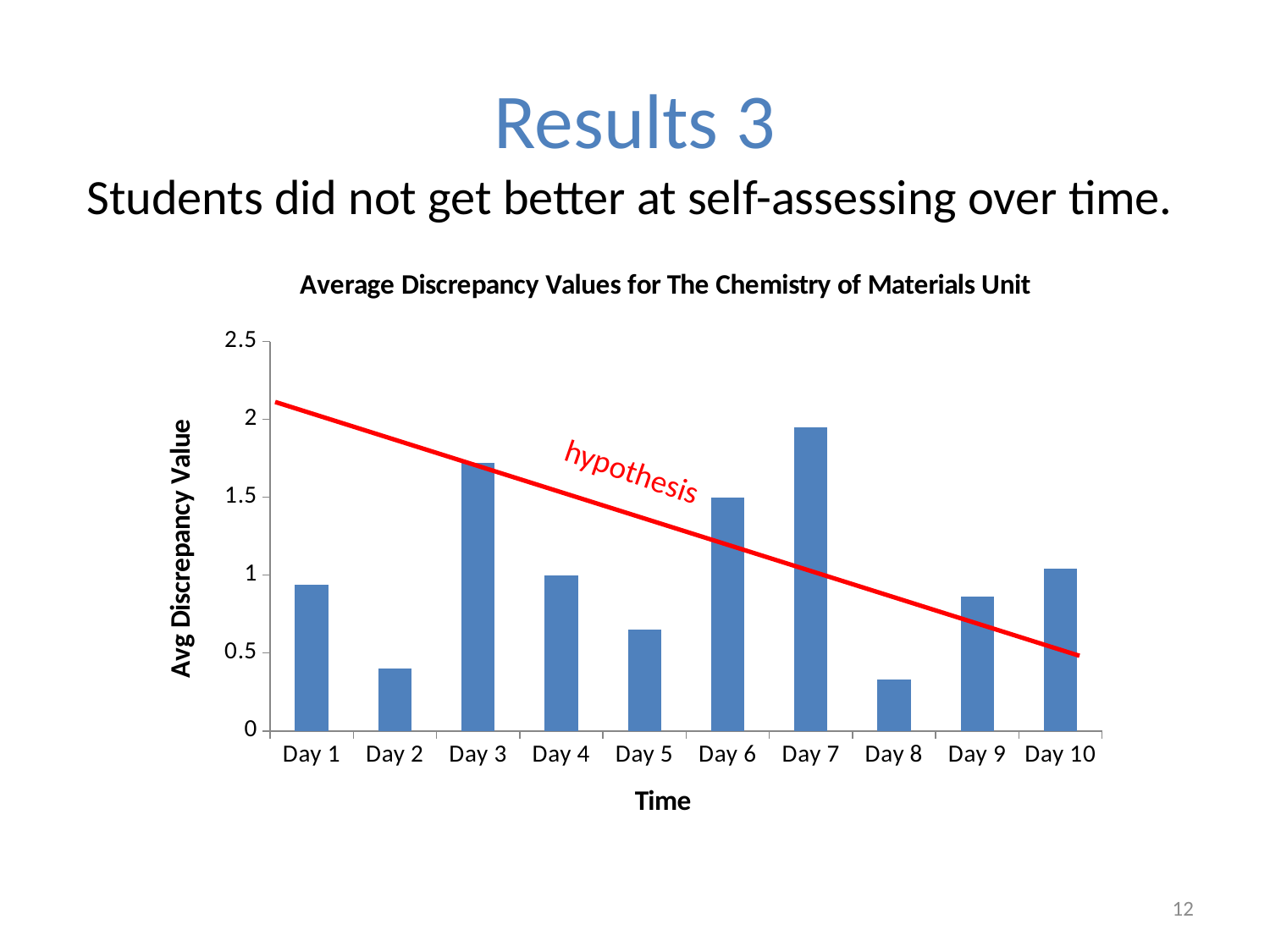
What type of chart is shown on the slide? bar chart Which has a higher average discrepancy value, Day 1 or Day 7? Day 7 Is the average discrepancy value for Day 6 greater or less than 1? greater What is the title of the chart? Average Discrepancy Values for The Chemistry of Materials Unit Is the average discrepancy value for Day 7 greater or less than 1.5? greater Which has a higher average discrepancy value, Day 3 or Day 6? Day 3 How many days are plotted on the x axis of the chart? 10 Is the average discrepancy value for Day 2 greater or less than 0.5? less What does the red line drawn across the chart represent? hypothesis Which day has the highest average discrepancy value? Day 7